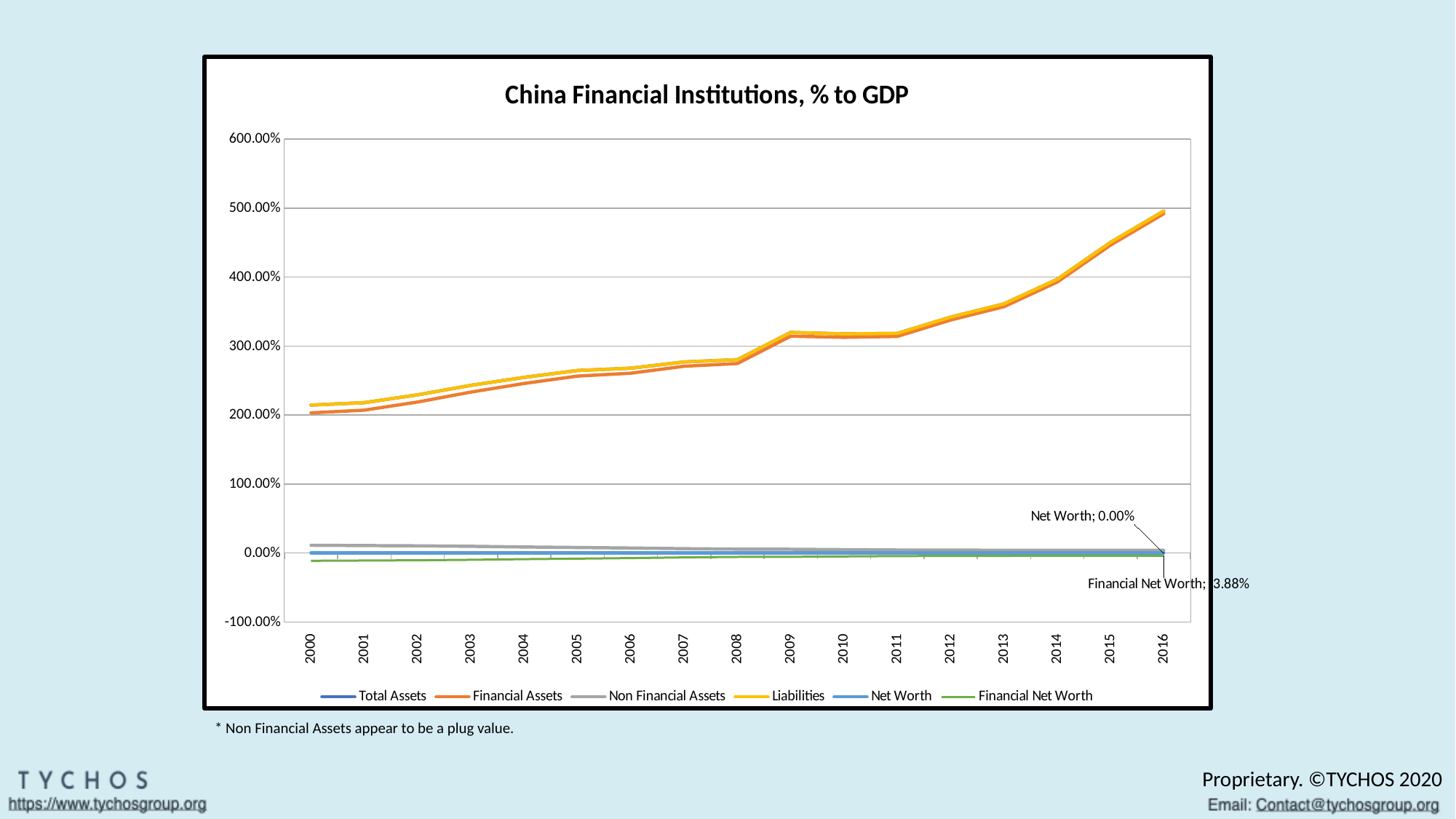
Do the Liabilities values rise or fall from 2000 to 2016? rise What is the value of Net Worth in 2016 according to the data label? 0.00% What is the title of the chart? China Financial Institutions, % to GDP Which is larger in 2000, Liabilities or Financial Assets? Liabilities Is the value for Financial Assets in 2000 greater or less than 300.00%? less How many years are plotted along the x axis of the chart? 17 According to the footnote below the chart, which series appears to be a plug value? Non Financial Assets Is the value for Liabilities in 2009 greater or less than 300.00%? greater What kind of chart is shown on the slide? line chart Is the value for Liabilities in 2016 greater or less than 400.00%? greater How many series does the legend of the chart list? 6